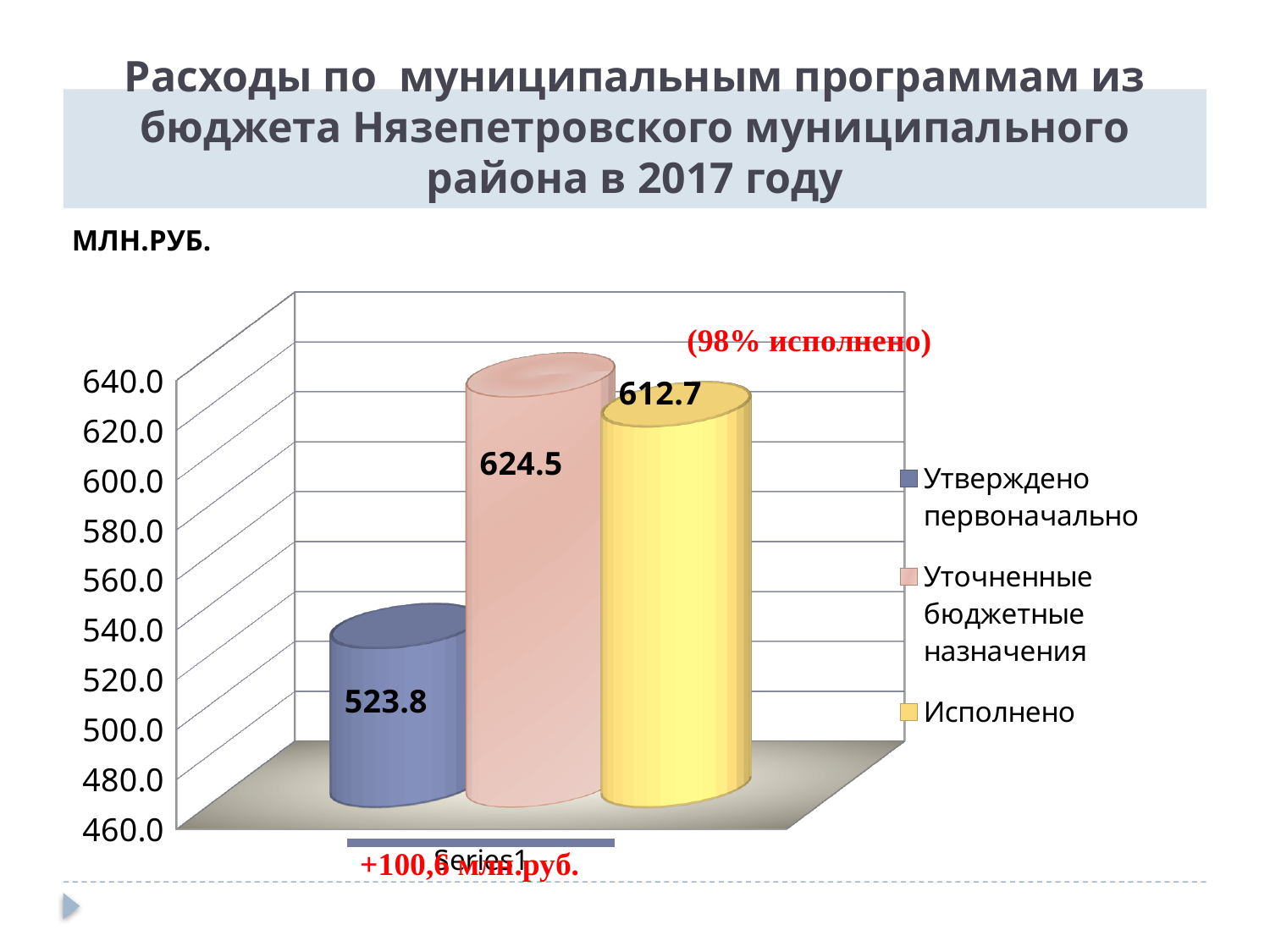
What is the difference between 'Уточненные бюджетные назначения' and 'Утверждено первоначально'? 100.7 What kind of chart is shown on the slide? bar chart What value is shown for 'Уточненные бюджетные назначения'? 624.5 How many series does the legend list? 3 Which is larger: 'Исполнено' or 'Утверждено первоначально'? Исполнено What is the difference between 'Уточненные бюджетные назначения' and 'Исполнено'? 11.8 Which series has the highest value? Уточненные бюджетные назначения What value is shown for 'Исполнено'? 612.7 Which series has the lowest value? Утверждено первоначально Is the value for 'Утверждено первоначально' greater or less than 540.0? less What value is shown for 'Утверждено первоначально'? 523.8 What unit is indicated above the chart? МЛН.РУБ.